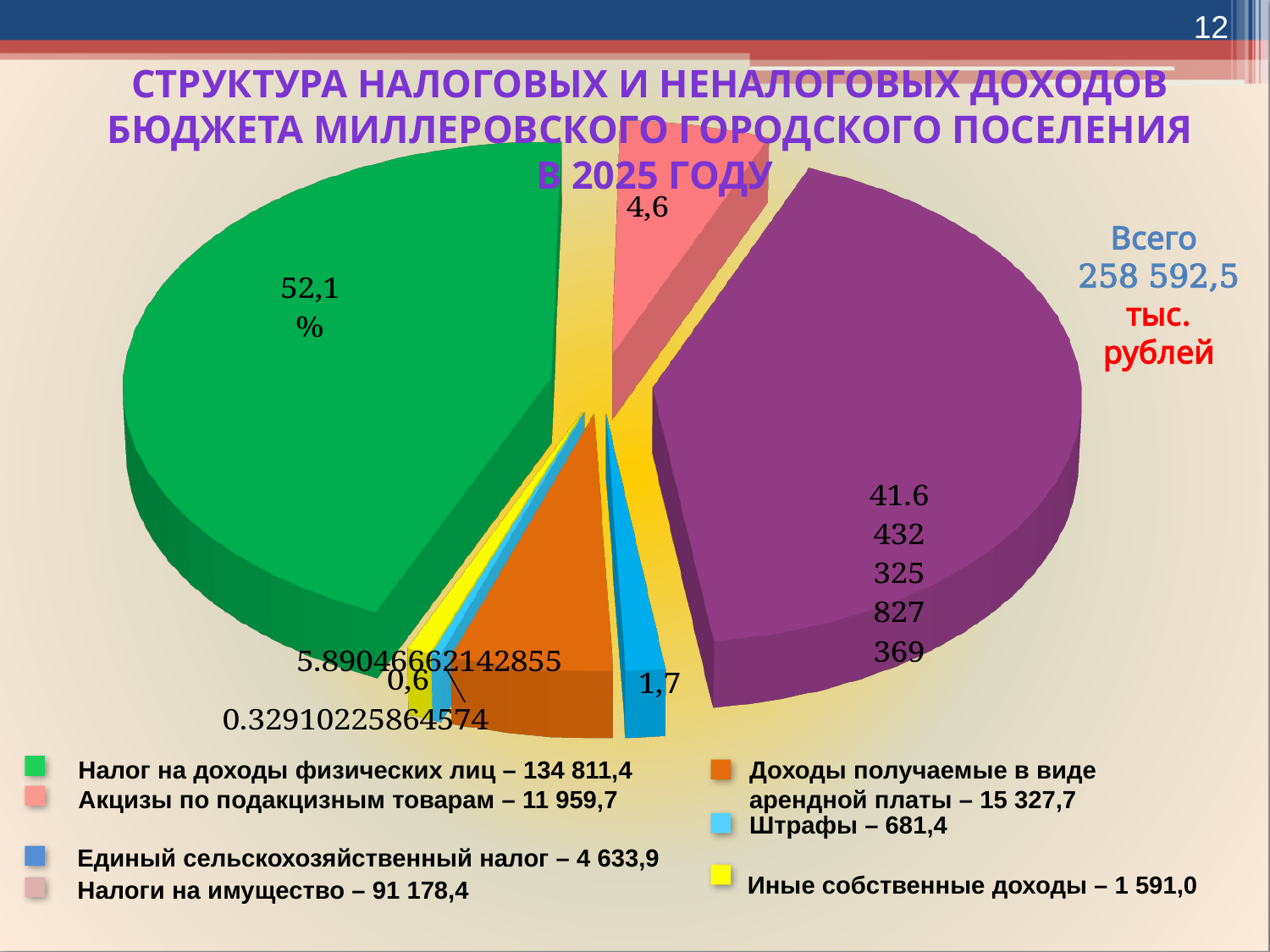
What is the difference between Налог на доходы физических лиц (134 811,4) and Налоги на имущество (91 178,4)? 43 633,0 What share of the pie is labelled on the pink slice (Акцизы по подакцизным товарам)? 4,6 What kind of chart is shown on the slide? Pie chart What is the value for Налог на доходы физических лиц according to the legend? 134 811,4 What is the value for Штрафы according to the legend? 681,4 Which category has the smallest value in the legend? Штрафы What share of the pie does the green slice (Налог на доходы физических лиц) represent? 52,1 % Which category has the largest share of the pie? Налог на доходы физических лиц How many categories does the legend of the pie chart list? 7 What is the value for Доходы получаемые в виде арендной платы? 15 327,7 What is the value for Налоги на имущество according to the legend? 91 178,4 What total amount (Всего) is shown on the slide? 258 592,5 тыс. рублей